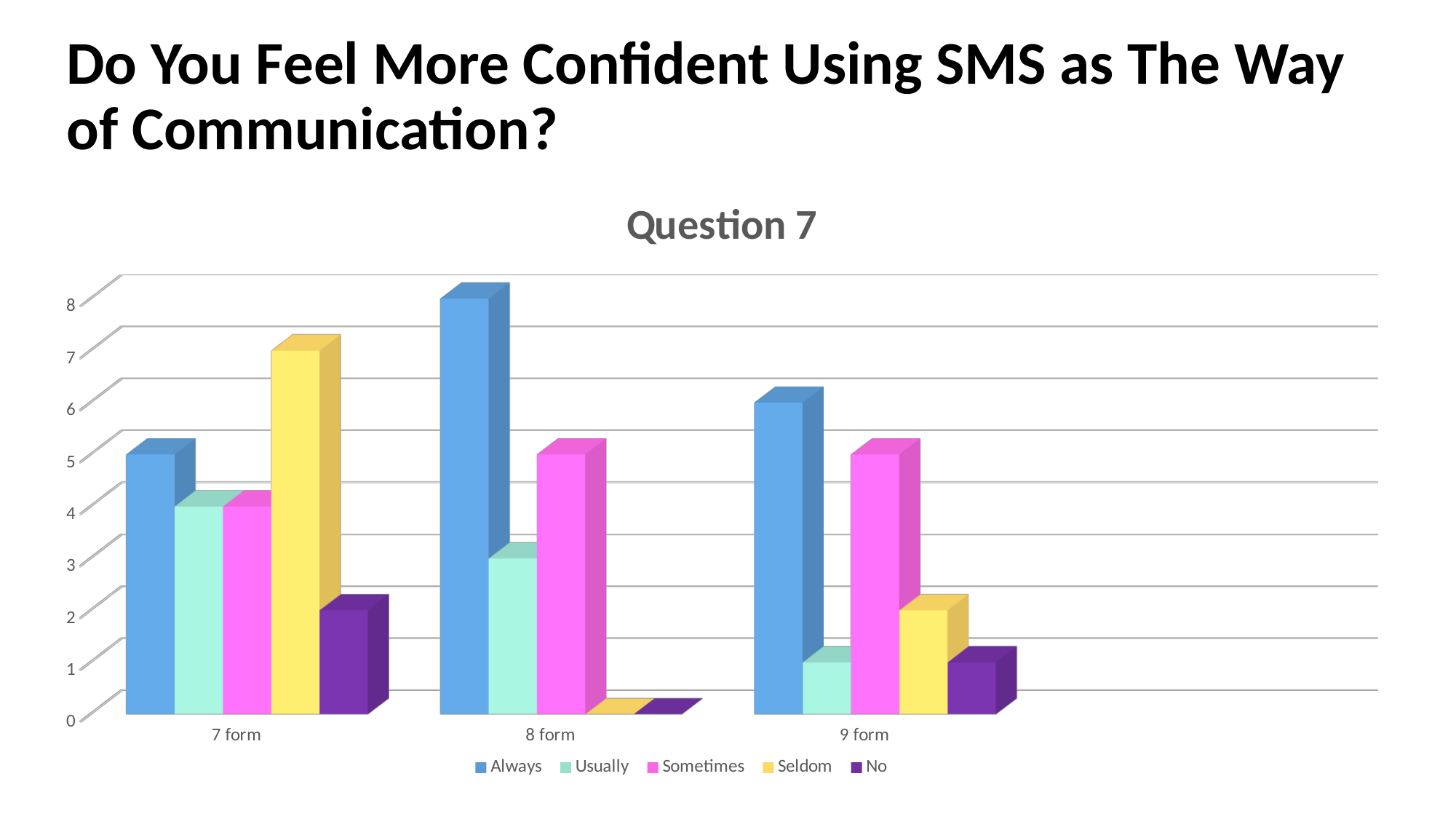
Is the value for Usually in 9 form greater or less than 3? less Which category has the lowest value for Seldom? 8 form What kind of chart is shown on the slide? bar chart Is the value for Always in 9 form greater or less than 4? greater Which series is shown in yellow in the legend? Seldom How many series does the legend list? 5 Which is larger in 7 form, Seldom or No? Seldom What is the value for Seldom in 7 form? 7 What is the title of the chart? Question 7 What is the value for Always in 8 form? 8 Which category has the highest value for Always? 8 form How many categories are shown on the x axis? 3